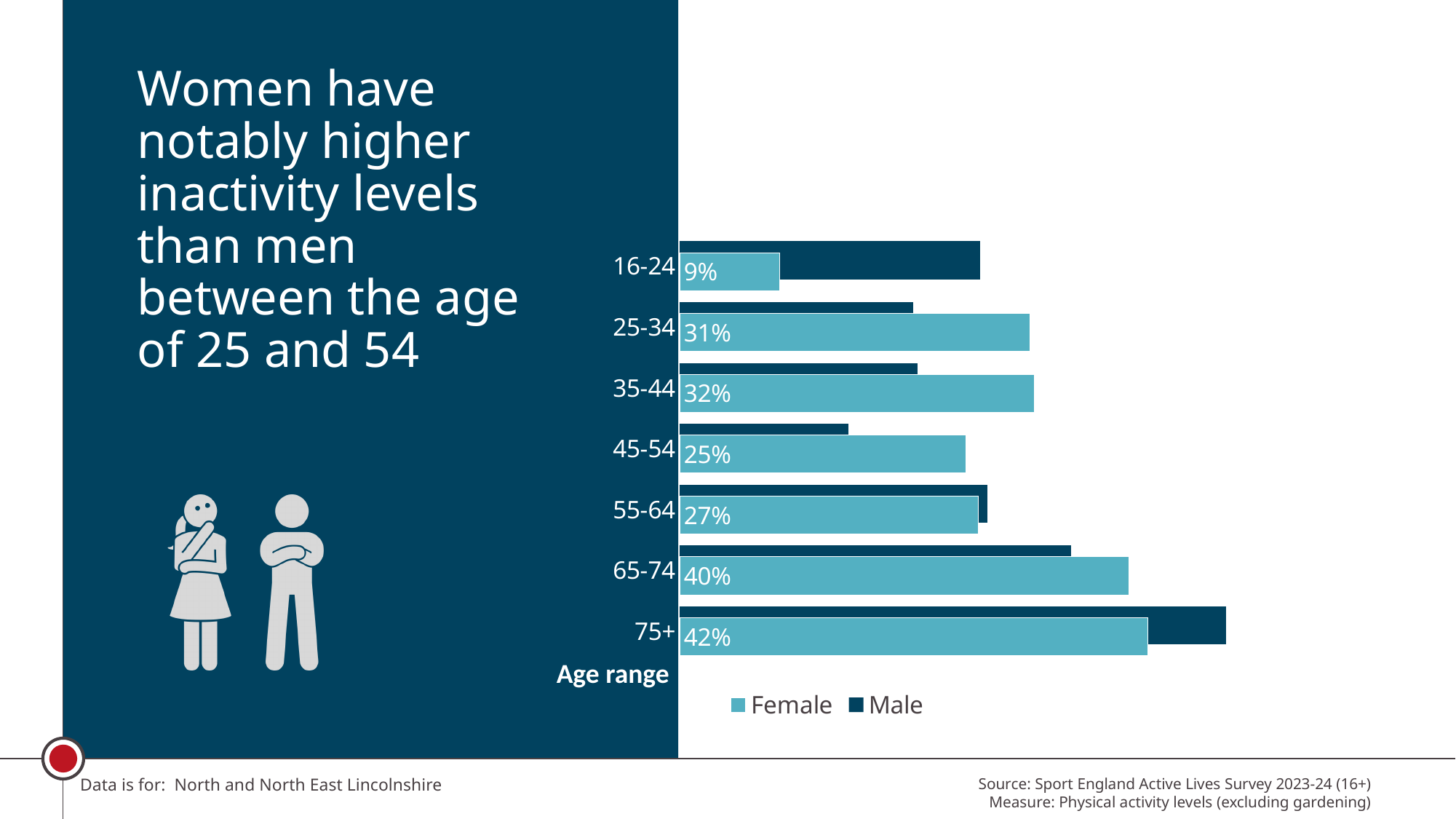
How many age ranges are shown on the chart? 7 What is the Female value for the 45-54 age range? 25% What is the difference between the Female values for 75+ and 16-24? 33 percentage points For the 35-44 age range, which is larger, the Female or the Male bar? Female What is the difference between the Female values for 35-44 and 45-54? 7 percentage points How many series does the legend list? 2 For the 16-24 age range, which is larger, the Female or the Male bar? Male What is the Female value for the 16-24 age range? 9% Which age range has the highest Female value? 75+ What kind of chart is shown on the slide? Bar chart Which age range has the lowest Female value? 16-24 What is the Female value for the 65-74 age range? 40%